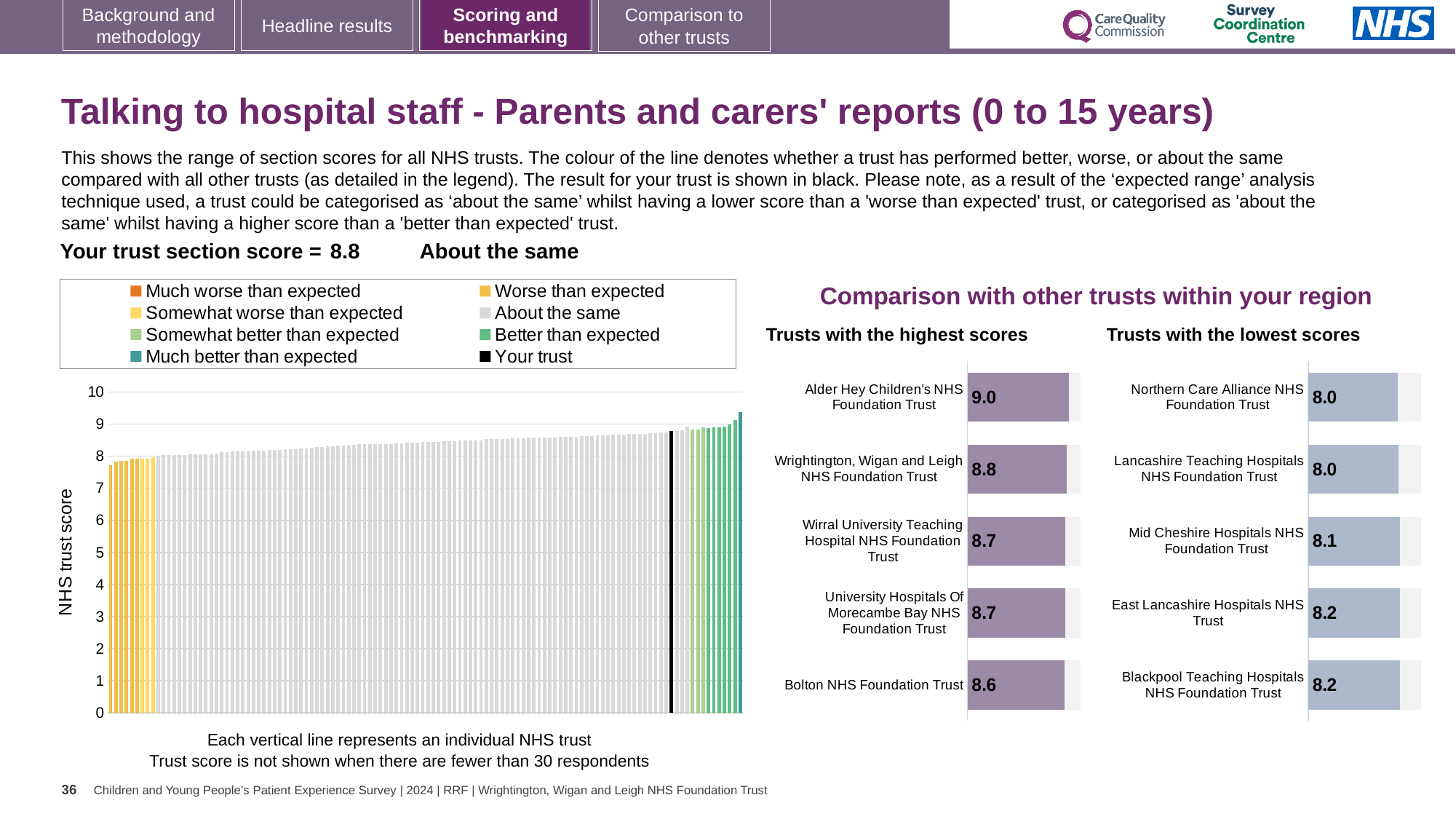
What kind of chart is the NHS trust score chart on the left of the slide? Bar chart How many entries does the legend of the NHS trust score chart on the left list? 8 How many trusts are listed in the 'Trusts with the lowest scores' chart? 5 In the 'Trusts with the highest scores' chart, which trust has the highest score? Alder Hey Children's NHS Foundation Trust In the 'Trusts with the lowest scores' chart, what is the score for Mid Cheshire Hospitals NHS Foundation Trust? 8.1 In the NHS trust score chart on the left, do the bar heights rise or fall from left to right? Rise In the 'Trusts with the highest scores' chart, which trust has the lowest score? Bolton NHS Foundation Trust In the 'Trusts with the highest scores' chart, what is the score for Bolton NHS Foundation Trust? 8.6 In the 'Trusts with the lowest scores' chart, what is the difference between the scores of East Lancashire Hospitals NHS Trust and Northern Care Alliance NHS Foundation Trust? 0.2 In the 'Trusts with the lowest scores' chart, which has the larger score: Mid Cheshire Hospitals NHS Foundation Trust or Lancashire Teaching Hospitals NHS Foundation Trust? Mid Cheshire Hospitals NHS Foundation Trust In the 'Trusts with the highest scores' chart, what is the score for Alder Hey Children's NHS Foundation Trust? 9.0 In the 'Trusts with the highest scores' chart, what is the difference between the scores of Alder Hey Children's NHS Foundation Trust and Bolton NHS Foundation Trust? 0.4